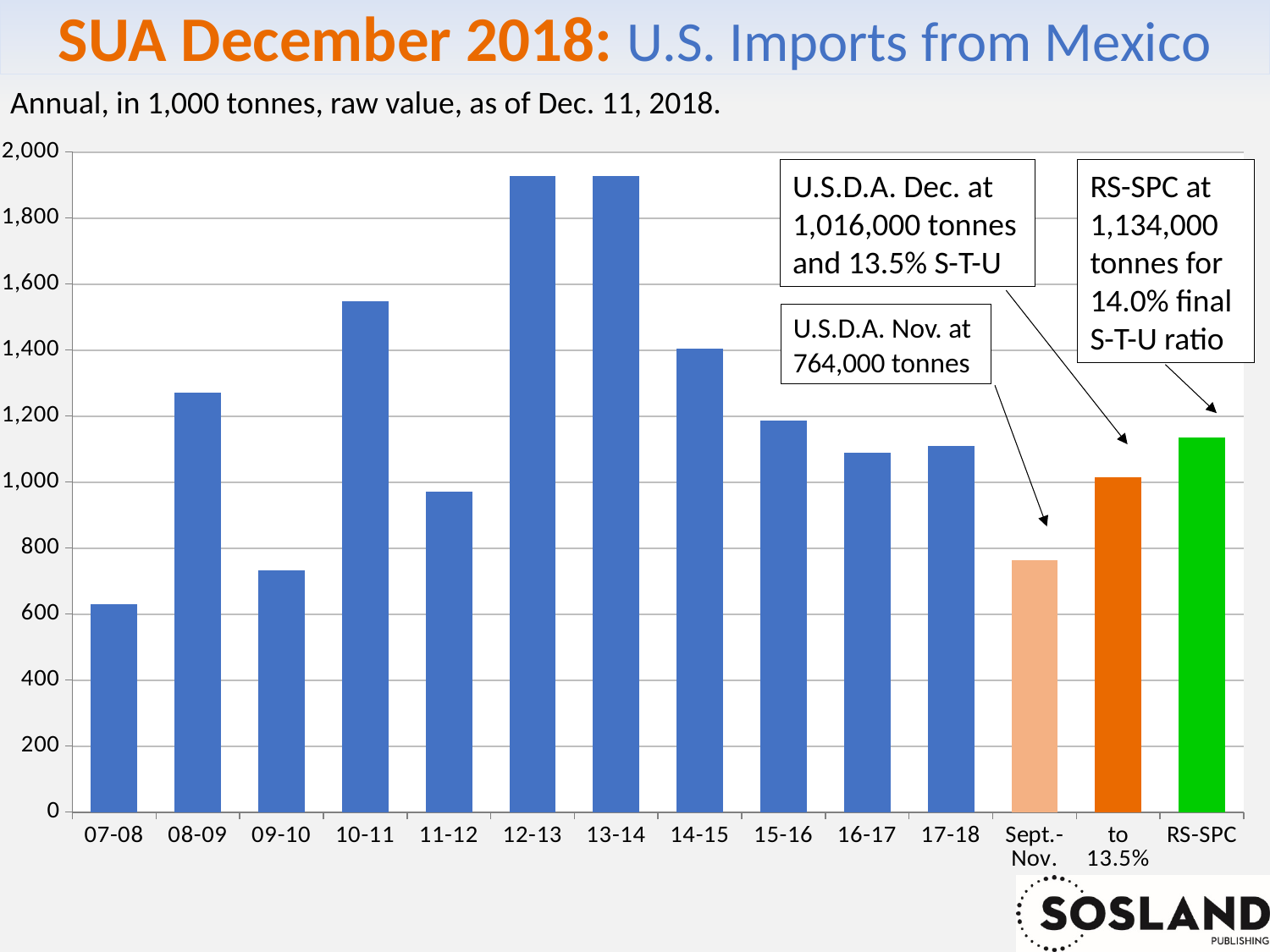
According to the annotation, what is the U.S.D.A. Nov. value for the Sept.-Nov. bar? 764,000 tonnes Is the value for 10-11 greater or less than 1,400? greater What kind of chart is shown on the slide? bar chart Which is larger, the value for 08-09 or the value for 09-10? 08-09 Do the values rise or fall from 13-14 to 17-18? fall Which category has the lowest bar? 07-08 According to the annotation, what is the U.S.D.A. Dec. value for the 'to 13.5%' bar? 1,016,000 tonnes Is the value for 11-12 greater or less than 1,000? less Is the value for 07-08 greater or less than 800? less How many bars (categories) are plotted on the x axis? 14 What is the difference between the RS-SPC value (1,134,000 tonnes) and the U.S.D.A. Dec. value (1,016,000 tonnes)? 118,000 tonnes According to the annotation, what is the RS-SPC value? 1,134,000 tonnes